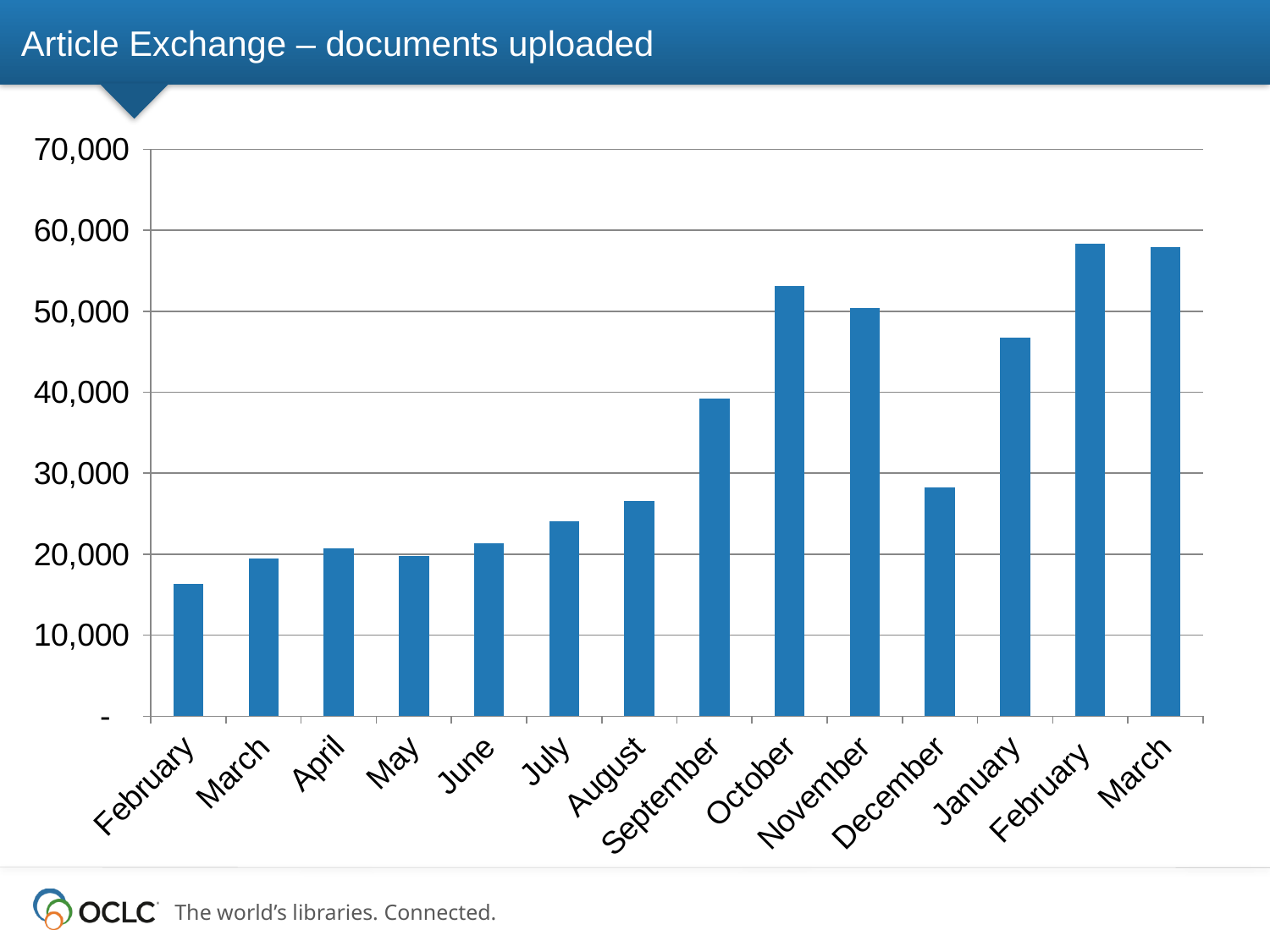
Is the value for January greater or less than 40,000? greater Is the value for August greater or less than 30,000? less Which month has the lowest number of documents uploaded? February (the first bar) How many bars (months) are plotted in the chart? 14 Which is larger, the value for December or the value for January? January Is the value for September greater or less than 40,000? less What is the title of the chart? Article Exchange – documents uploaded What kind of chart is shown on the slide? bar chart Which is larger, the value for October or the value for November? October Overall, do the values rise or fall from the first February to the final March? rise